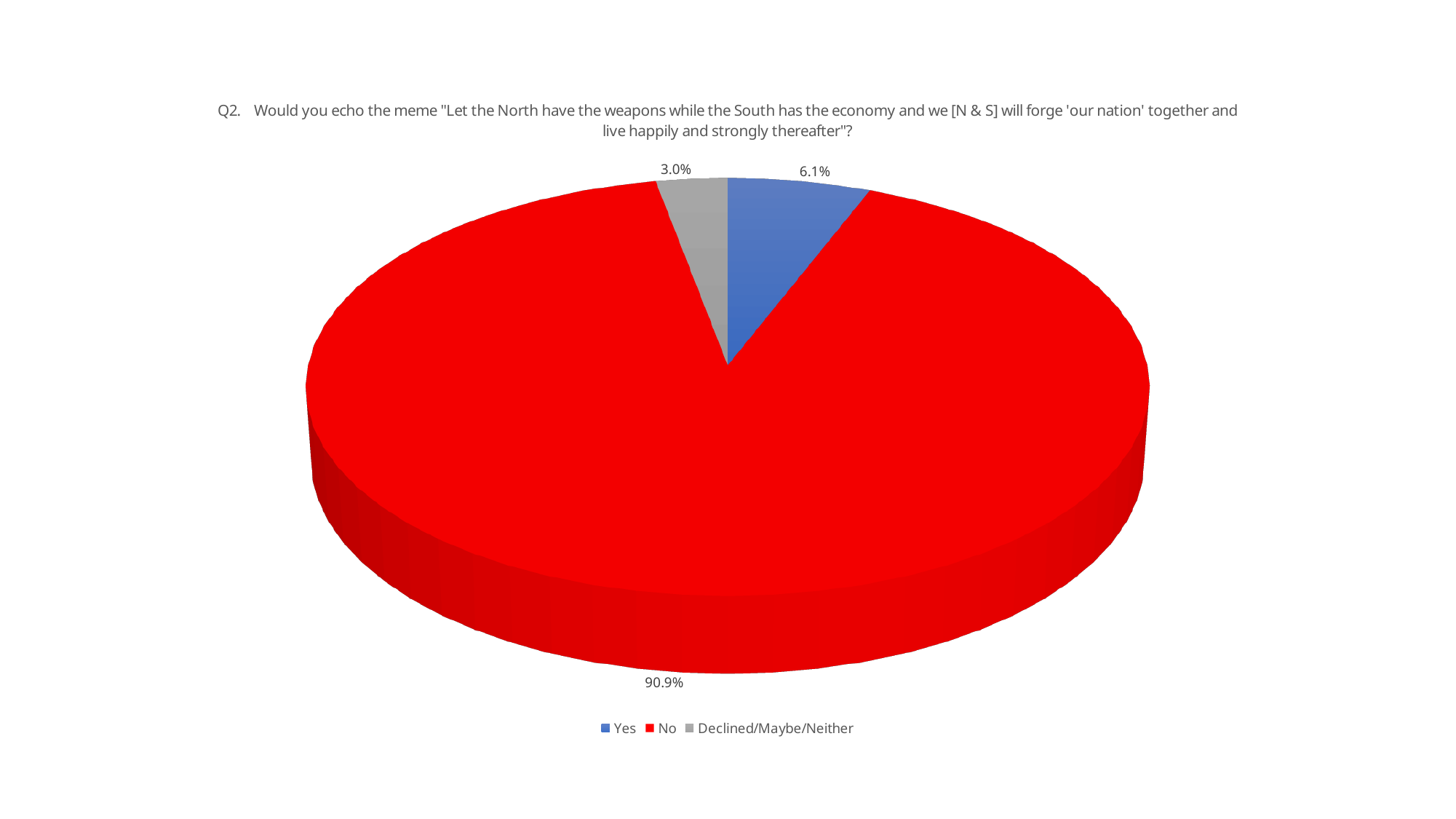
What share of responses is "No"? 90.9% What share of responses is "Declined/Maybe/Neither"? 3.0% Which is larger, the "Yes" slice or the "Declined/Maybe/Neither" slice? Yes What share of responses is "Yes"? 6.1% What is the difference in percentage points between the "Yes" and "Declined/Maybe/Neither" slices? 3.1 What kind of chart is shown on the slide? pie chart Which response category has the largest slice? No How many slices does the pie chart have? 3 Which response category has the smallest slice? Declined/Maybe/Neither How many entries does the legend list? 3 What colour is the "No" slice? red What is the difference in percentage points between the "No" and "Yes" slices? 84.8